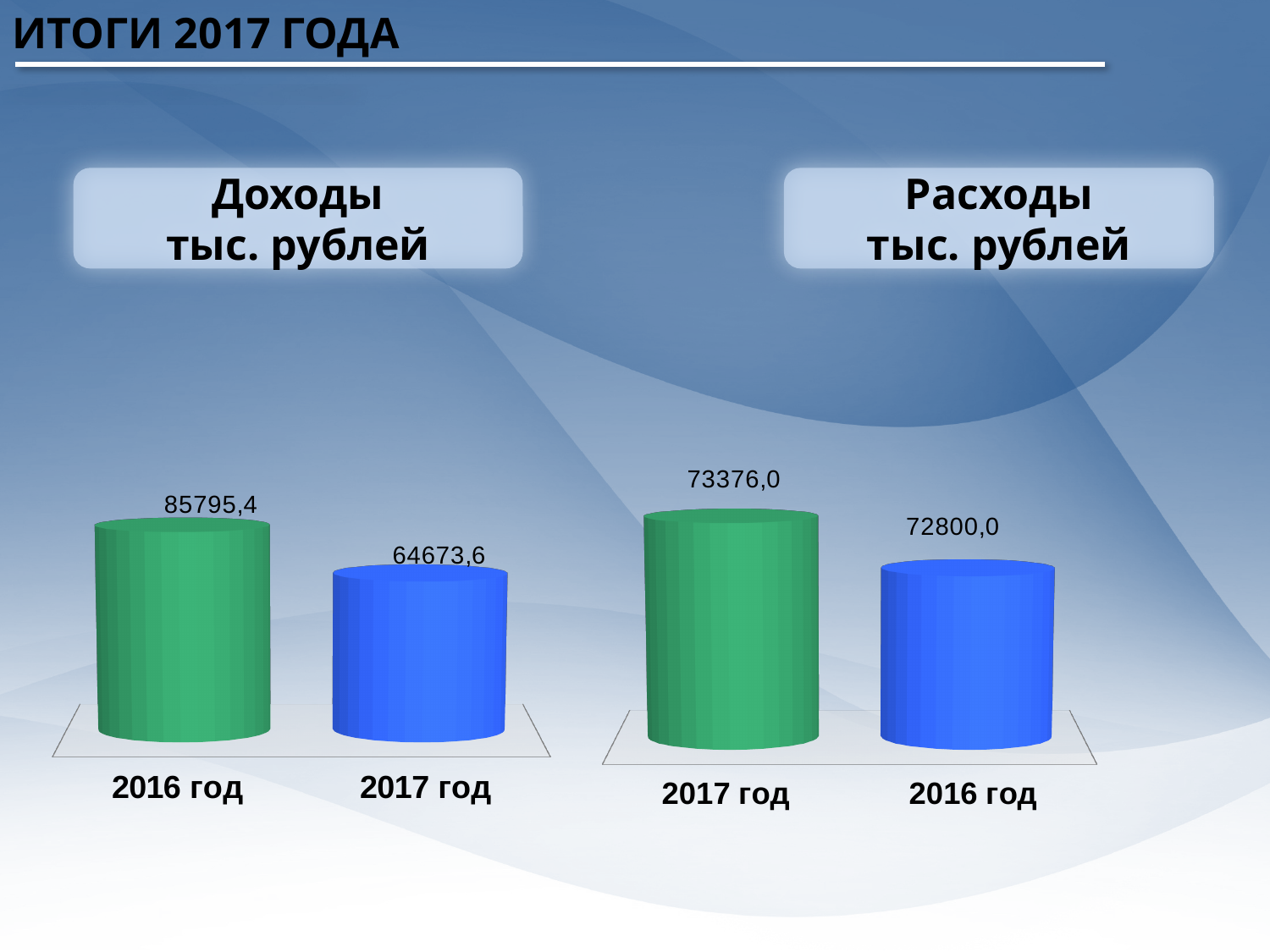
In the Расходы chart, what is the value for 2016 год? 72800,0 In the Расходы chart, what is the value for 2017 год? 73376,0 How many categories are shown in the Доходы chart? 2 What unit is stated in the title of the Доходы chart? тыс. рублей In the Доходы chart, which year has the higher value? 2016 год In the Доходы chart, what is the value for 2016 год? 85795,4 In the Расходы chart, is the value for 2017 год larger or smaller than the value for 2016 год? larger What kind of chart is the Расходы chart? bar chart In the Расходы chart, which year has the lower value? 2016 год In the Доходы chart, what is the difference between the 2016 год and 2017 год values? 21121,8 In the Расходы chart, what is the difference between the 2017 год and 2016 год values? 576,0 In the Доходы chart, what is the value for 2017 год? 64673,6